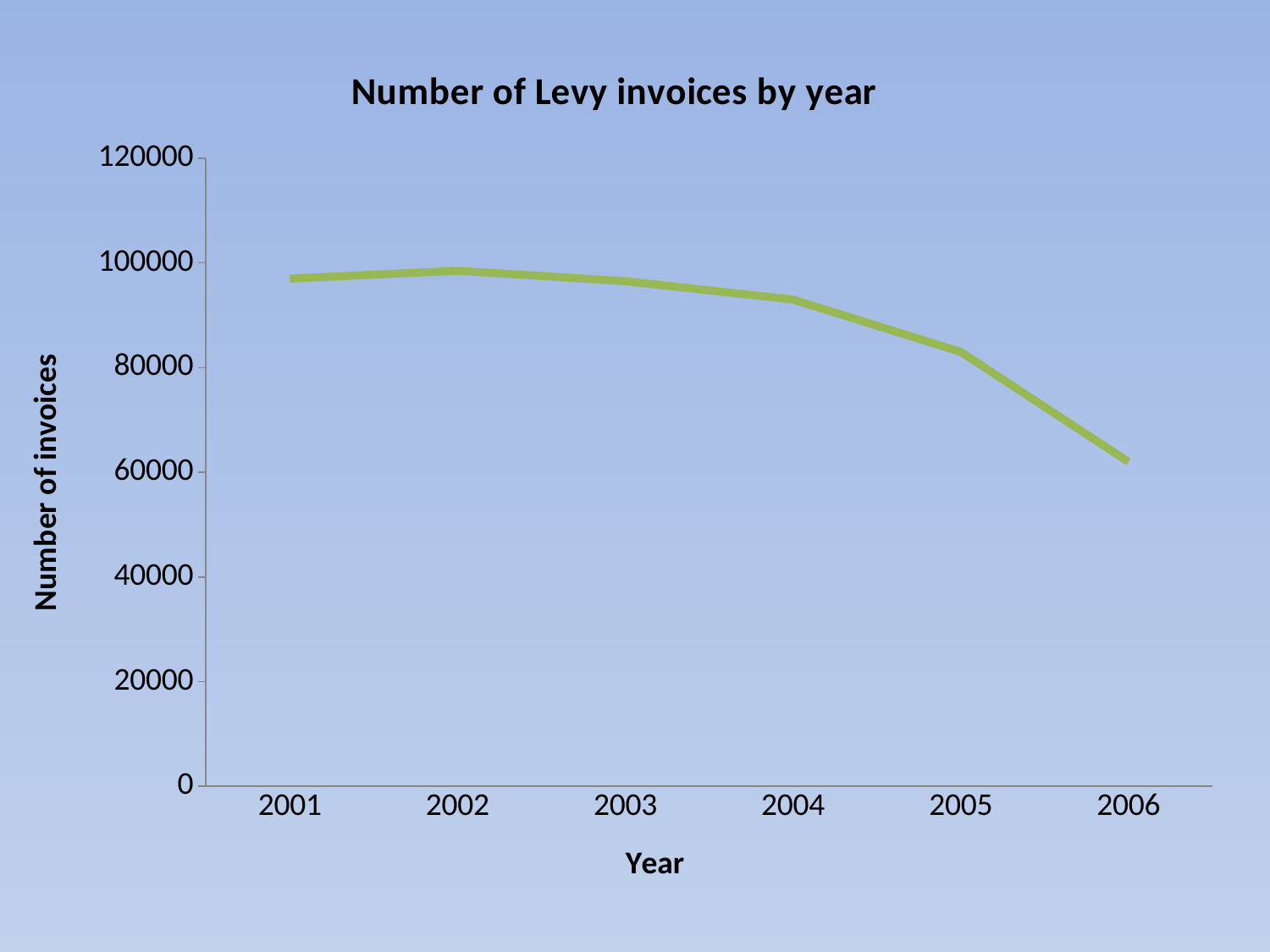
Which year has the lowest number of Levy invoices? 2006 Do the number of invoices rise or fall from 2004 to 2006? fall Which year has more Levy invoices, 2004 or 2006? 2004 What is the label of the vertical axis? Number of invoices Is the value for 2001 greater or less than 100000? less Which year has more Levy invoices, 2001 or 2005? 2001 How many years are plotted on the x axis? 6 Is the value for 2004 greater or less than 80000? greater Is the value for 2006 greater or less than 80000? less What is the title of the chart? Number of Levy invoices by year What kind of chart is shown on the slide? line chart